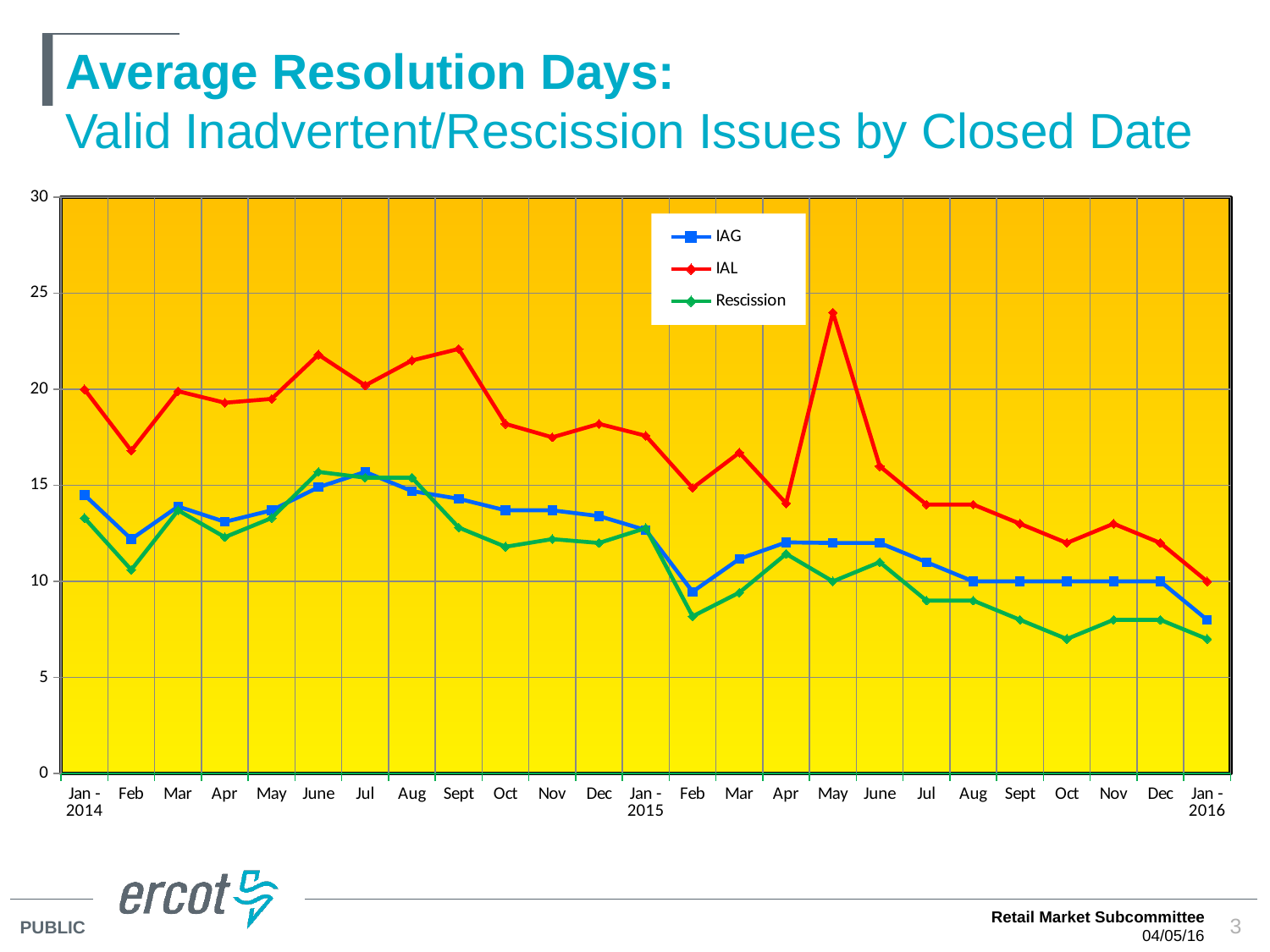
Is the IAG value for Jan 2016 greater or less than 10? less How many monthly points are plotted along the x axis? 25 In which month does the IAL series reach its highest value? May 2015 Which series has the highest value at any point on the chart? IAL Does the IAL series overall rise or fall from Jan 2015 to Jan 2016? fall Which is larger in Jan 2014, the IAL value or the IAG value? IAL Is the IAL value for Feb 2014 greater or less than 20? less What kind of chart is shown on the slide? line chart How many series does the legend list? 3 Is the IAL value for May 2015 greater or less than 20? greater What is the title of the chart on the slide? Average Resolution Days: Valid Inadvertent/Rescission Issues by Closed Date